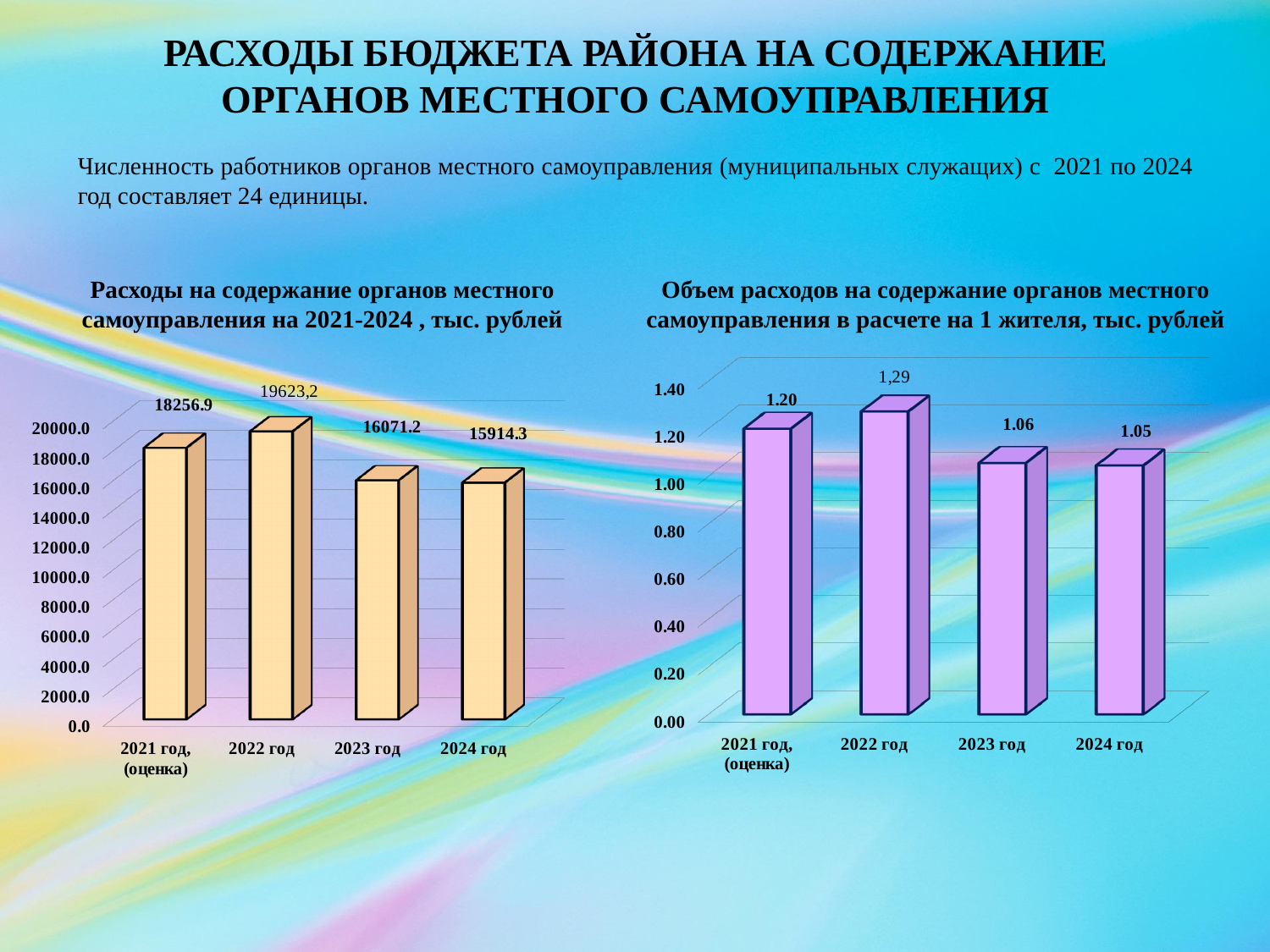
In the right chart, which year has the highest value? 2022 год In the left chart, how many years are shown on the x axis? 4 In the left chart, which year has the lowest value? 2024 год In the left chart, what is the value for 2022 год? 19623,2 In the right chart, what is the value for 2023 год? 1.06 What kind of chart is the right chart? bar chart In the right chart, what is the difference between the values for 2022 год and 2021 год (оценка)? 0.09 In the left chart, what is the value for 2024 год? 15914.3 In the left chart, which year has the highest value? 2022 год In the left chart, what is the difference between the values for 2022 год and 2021 год (оценка)? 1366.3 In the right chart, what is the value for 2021 год (оценка)? 1.20 In the right chart, is the value for 2022 год larger or smaller than the value for 2024 год? larger